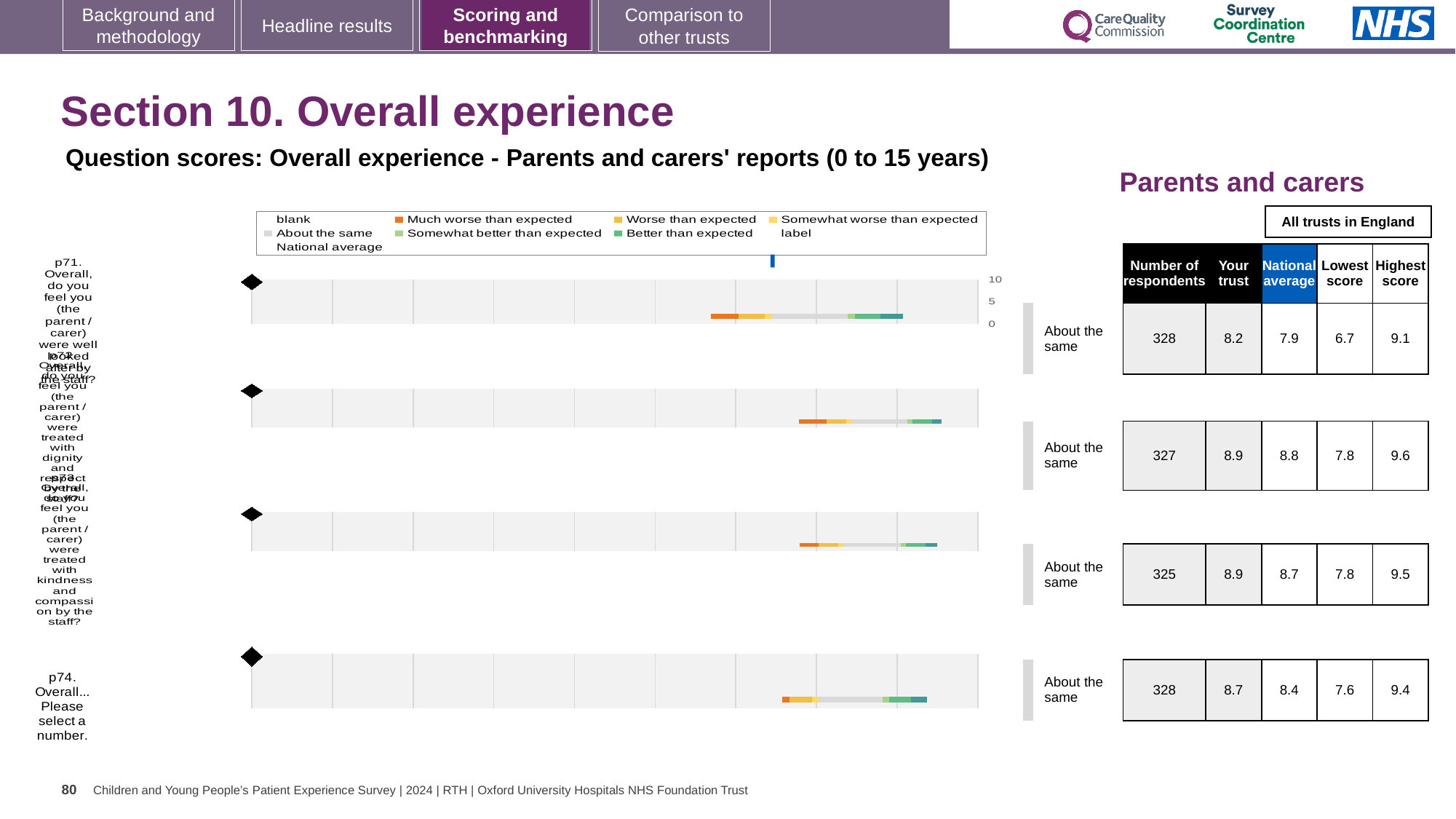
In the table beside the chart, what is the 'Your trust' score for the first row (p71)? 8.2 In the table beside the chart, what is the Highest score for the bottom row (p74)? 9.4 In the table beside the chart, which is larger for the third row (p73): 'Your trust' or the National average? Your trust How many horizontal bars (question rows) are plotted in the chart? 4 What is the label of the last (bottom) question row in the chart? p74. Overall... Please select a number. How many entries does the chart legend list? 9 In the table beside the chart, what is the difference between 'Your trust' and the National average for the bottom row (p74)? 0.3 In the table beside the chart, what is the National average for the first row (p71)? 7.9 Which legend entry is shown in orange? Much worse than expected In the table beside the chart, what is the Number of respondents for the second row (p72)? 327 What kind of chart is shown on the slide? bar chart In the table beside the chart, which row has the lowest 'Lowest score'? p71 (6.7)